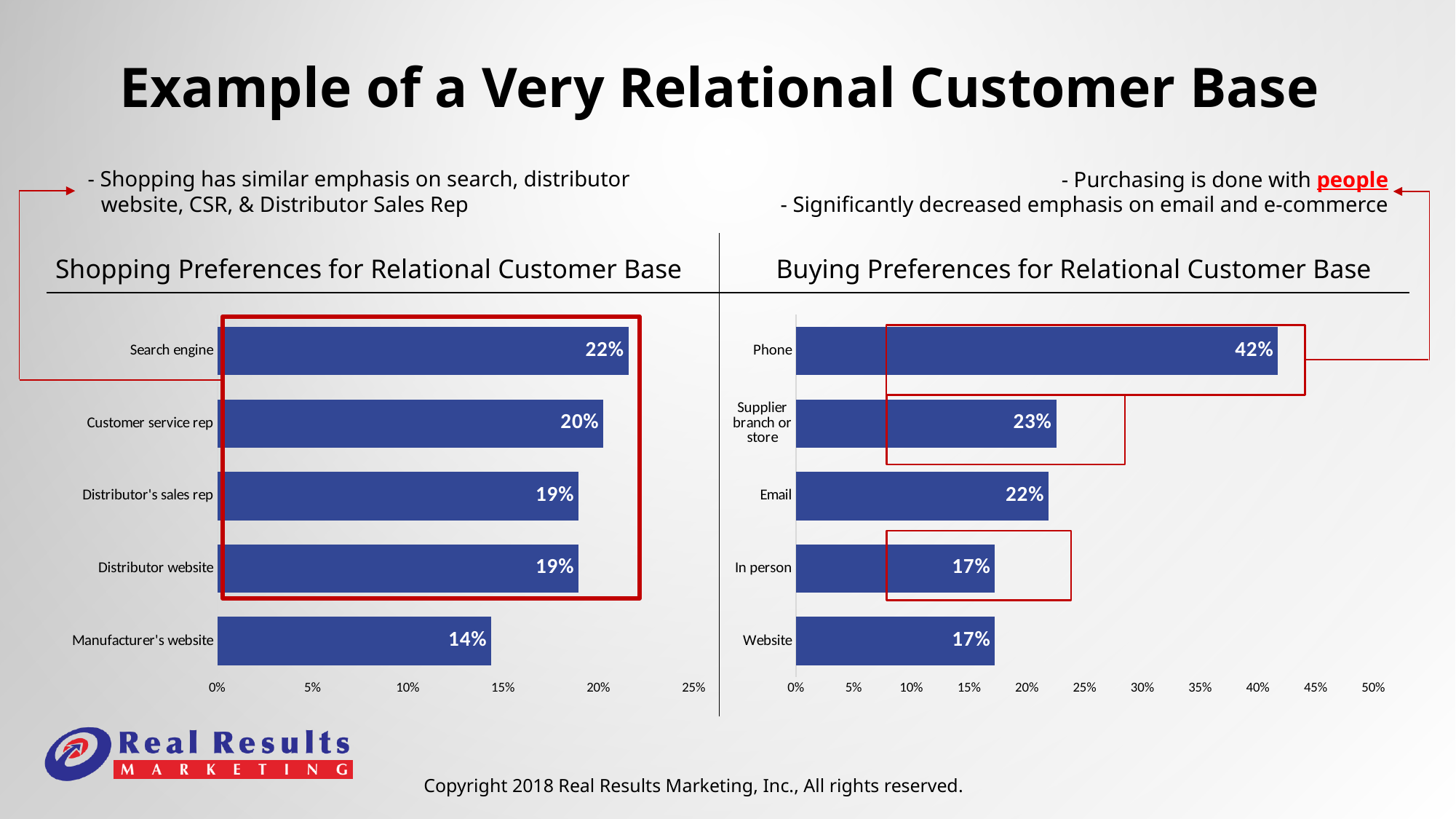
In the Buying Preferences for Relational Customer Base chart, what is the value for Supplier branch or store? 23% In the Buying Preferences for Relational Customer Base chart, what is the difference between Phone and Email? 20% In the Shopping Preferences for Relational Customer Base chart, which category has the highest value? Search engine In the Buying Preferences for Relational Customer Base chart, what is the value for Phone? 42% How many categories are shown in the Buying Preferences for Relational Customer Base chart? 5 In the Shopping Preferences for Relational Customer Base chart, what is the difference between Customer service rep and Manufacturer's website? 6% What type of chart is the Shopping Preferences for Relational Customer Base chart? Bar chart In the Buying Preferences for Relational Customer Base chart, which is larger, Supplier branch or store or In person? Supplier branch or store In the Shopping Preferences for Relational Customer Base chart, what is the value for Manufacturer's website? 14% In the Buying Preferences for Relational Customer Base chart, which category has the highest value? Phone In the Shopping Preferences for Relational Customer Base chart, what is the value for Search engine? 22% In the Shopping Preferences for Relational Customer Base chart, which category has the lowest value? Manufacturer's website